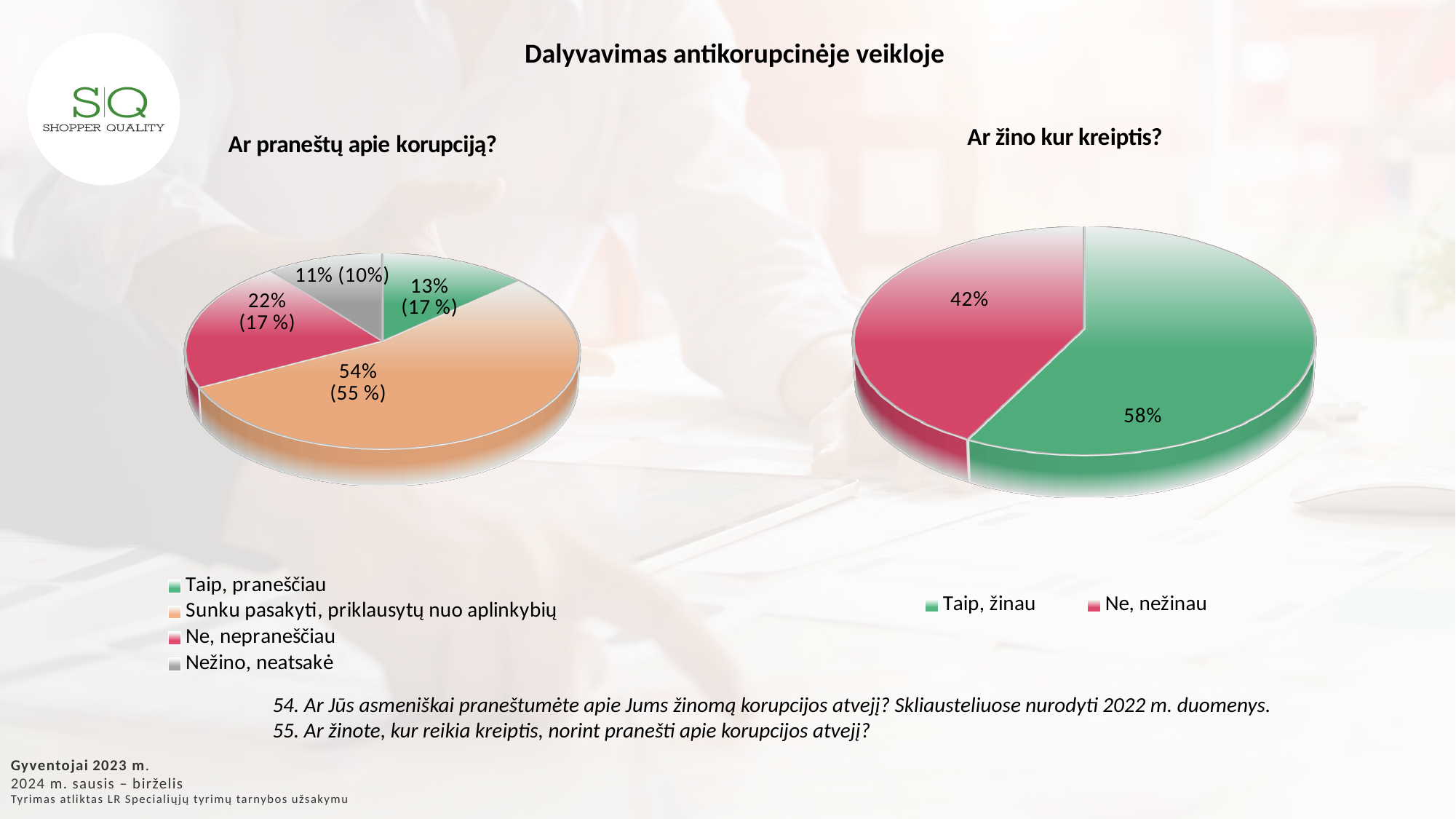
In the 'Ar praneštų apie korupciją?' chart, which category has the largest share? Sunku pasakyti, priklausytų nuo aplinkybių In the 'Ar žino kur kreiptis?' chart, what is the value for 'Taip, žinau'? 58% In the 'Ar praneštų apie korupciją?' chart, what is the difference between 'Ne, nepraneščiau' and 'Taip, praneščiau'? 9 percentage points In the 'Ar praneštų apie korupciją?' chart, what is the value for 'Taip, praneščiau'? 13% In the 'Ar žino kur kreiptis?' chart, which is larger, 'Taip, žinau' or 'Ne, nežinau'? Taip, žinau In the 'Ar praneštų apie korupciją?' chart, which category has the smallest share? Nežino, neatsakė In the 'Ar praneštų apie korupciją?' chart, what is the value for 'Ne, nepraneščiau'? 22% In the 'Ar praneštų apie korupciją?' chart, what is the 2022 value shown in brackets for 'Nežino, neatsakė'? 10% In the 'Ar praneštų apie korupciją?' chart, what is the value for 'Sunku pasakyti, priklausytų nuo aplinkybių'? 54% In the 'Ar praneštų apie korupciją?' chart, how many categories does the legend list? 4 What type of chart is used for 'Ar žino kur kreiptis?'? Pie chart In the 'Ar žino kur kreiptis?' chart, what is the value for 'Ne, nežinau'? 42%